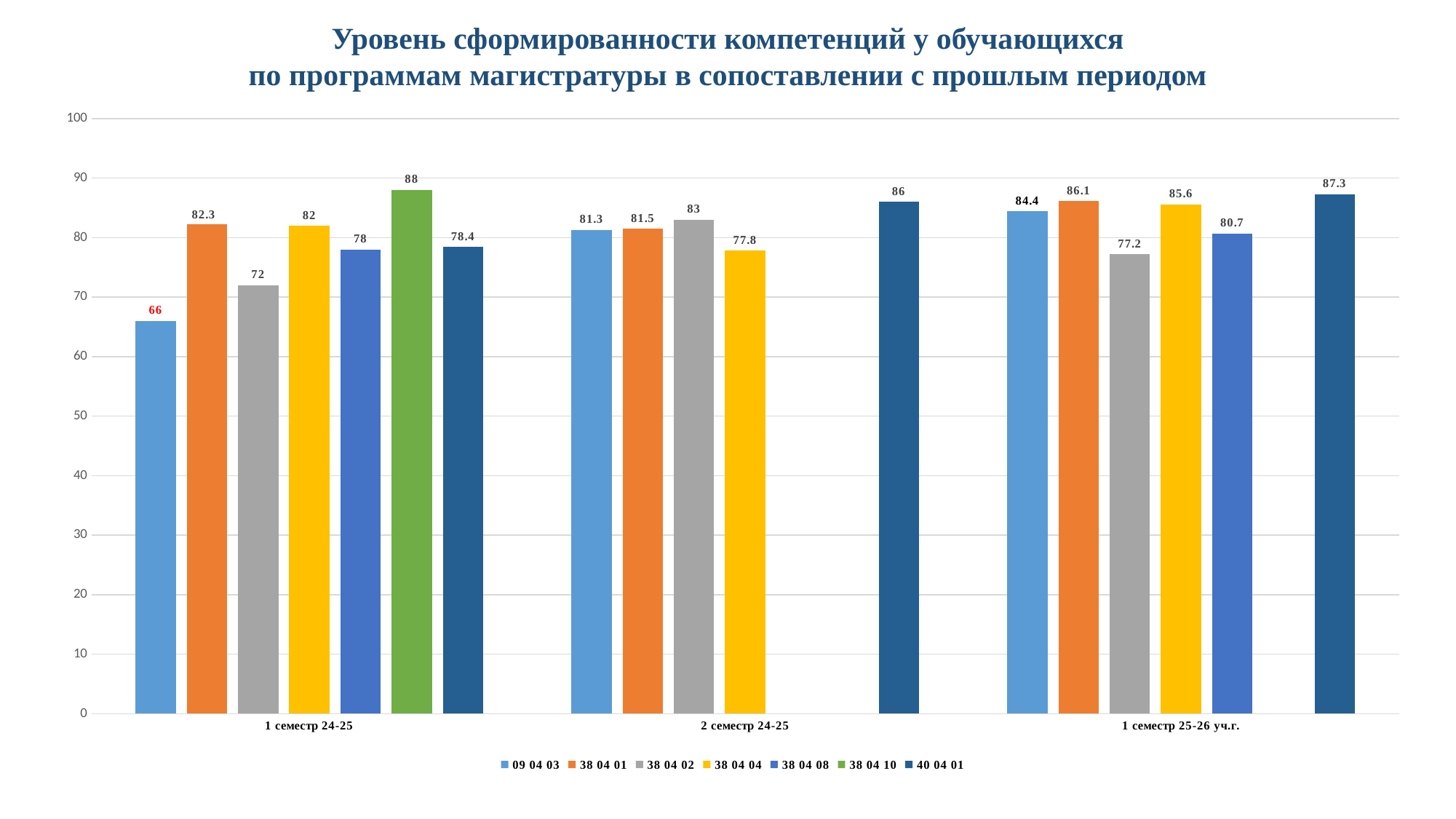
Which is larger: the value for 38 04 04 in 2 семестр 24-25 or in 1 семестр 25-26 уч.г.? 1 семестр 25-26 уч.г. How many series does the legend list? 7 What is the value for 09 04 03 in 1 семестр 24-25? 66 What is the value for 38 04 02 in 1 семестр 25-26 уч.г.? 77.2 Which series has the lowest value in 1 семестр 24-25? 09 04 03 How many categories are shown on the x axis? 3 What is the value for 38 04 10 in 1 семестр 24-25? 88 What is the value for 40 04 01 in 2 семестр 24-25? 86 What is the difference between the values for 38 04 10 and 09 04 03 in 1 семестр 24-25? 22 Which series has the highest value in 1 семестр 25-26 уч.г.? 40 04 01 What kind of chart is shown on the slide? Bar chart Do the values for 09 04 03 rise or fall across the three periods? Rise